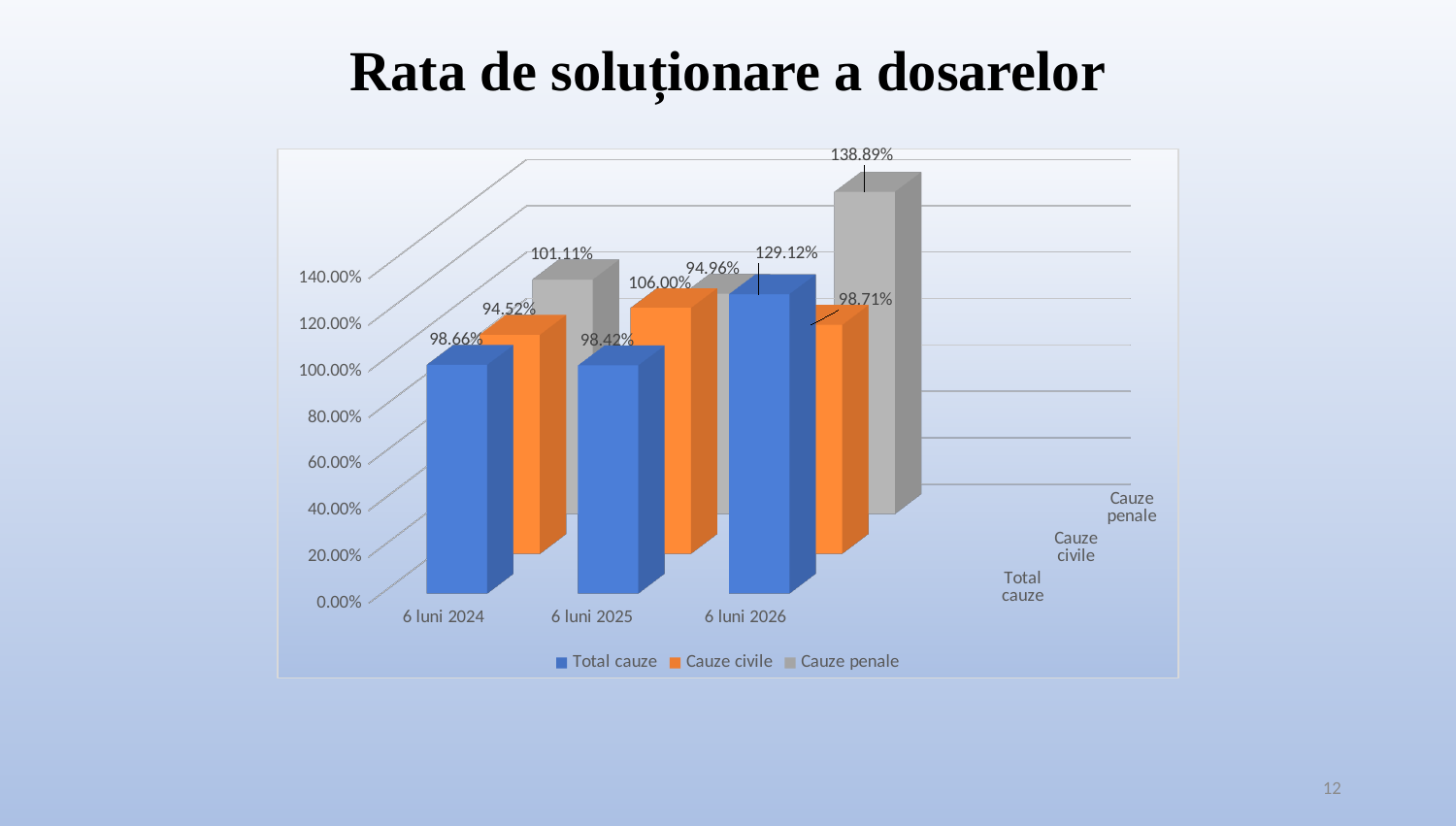
How many series does the legend list? 3 What is the value for Total cauze in 6 luni 2024? 98.66% What is the value for Cauze civile in 6 luni 2025? 106.00% Which category has the highest value for Cauze penale? 6 luni 2026 What kind of chart is shown on the slide? Bar chart What is the value for Cauze penale in 6 luni 2026? 138.89% Which category has the lowest value for Total cauze? 6 luni 2025 How many categories are shown on the x axis? 3 What is the difference between Total cauze in 6 luni 2026 and Total cauze in 6 luni 2025? 30.70% What is the value for Cauze penale in 6 luni 2024? 101.11% What is the title of the chart? Rata de soluționare a dosarelor Which is larger: Cauze civile in 6 luni 2025 or Cauze penale in 6 luni 2025? Cauze civile in 6 luni 2025